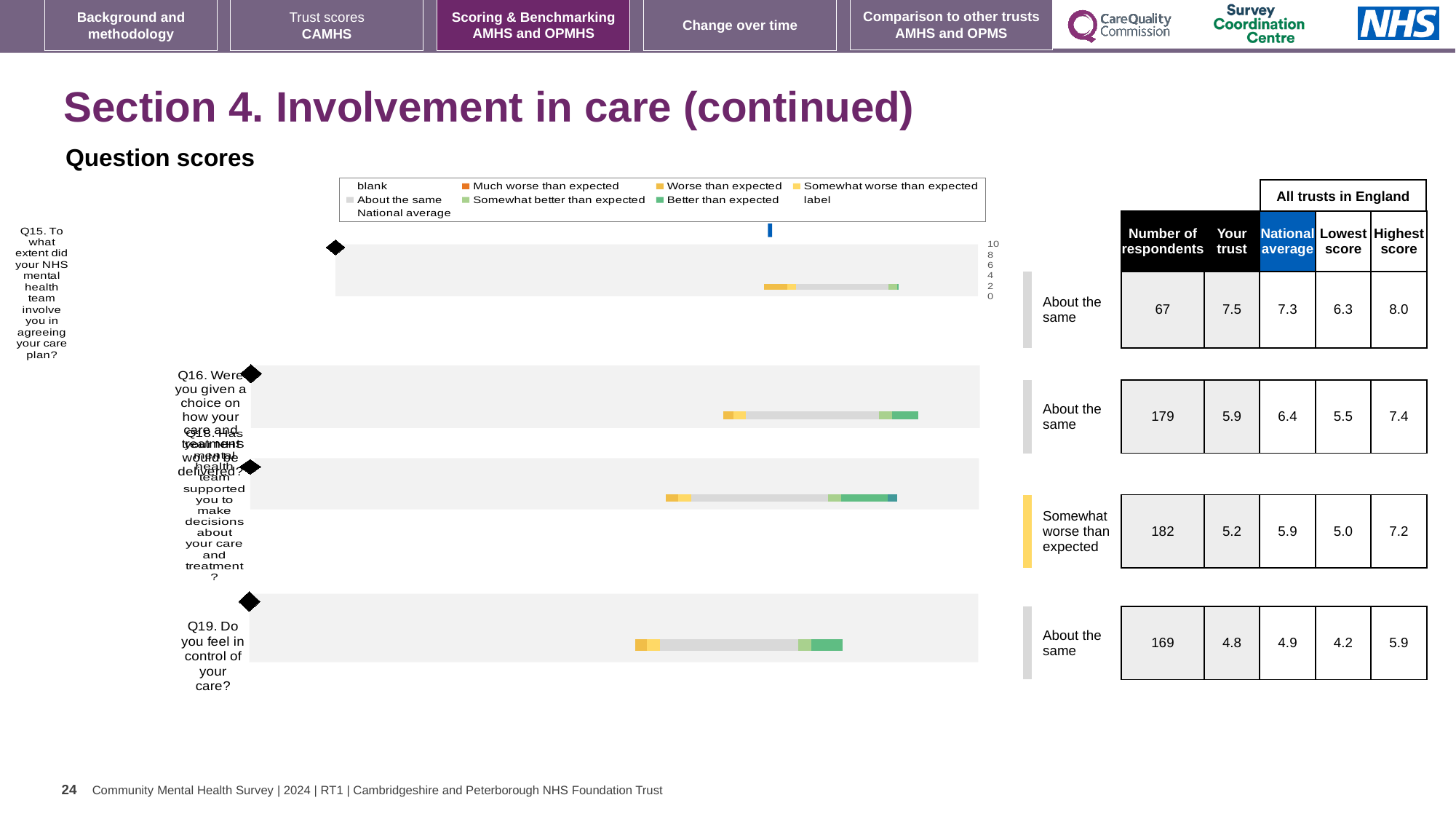
What is the national average score for Q16 (Were you given a choice on how your care and treatment would be delivered?)? 6.4 How many questions are plotted on the slide? 4 Which question has the highest 'Your trust' score? Q15 What is the 'Your trust' score for Q19 (Do you feel in control of your care?)? 4.8 For Q16, which is larger: the 'Your trust' score or the national average? National average For Q18, what is the difference between the national average and the 'Your trust' score? 0.7 What kind of chart is used to show the question scores? Bar chart Which question has the lowest national average score? Q19 What is the highest score among all trusts in England for Q15? 8.0 Which question is rated 'Somewhat worse than expected'? Q18 What is the lowest score among all trusts in England for Q19? 4.2 How many respondents answered Q18 (Has your NHS mental health team supported you to make decisions about your care and treatment?)? 182